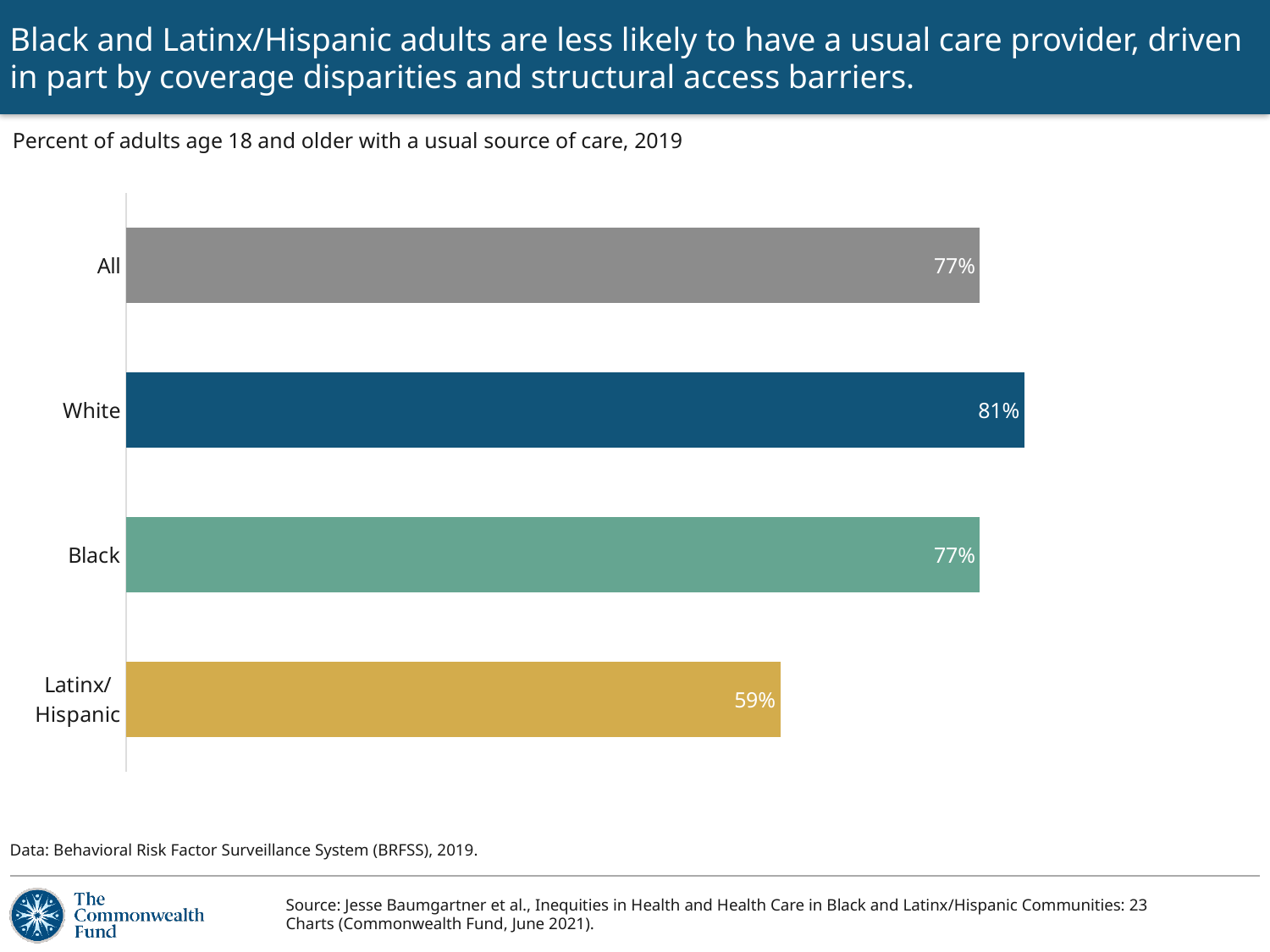
Which group has the lowest percent of adults with a usual source of care? Latinx/Hispanic What kind of chart is shown on the slide? Bar chart What is the value shown for Black adults? 77% What percent of White adults had a usual source of care in 2019? 81% What is the difference in percentage points between White and Black adults? 4 percentage points Which group has the highest percent of adults with a usual source of care? White How many groups are shown in the chart? 4 What is the difference in percentage points between White and Latinx/Hispanic adults? 22 percentage points What is the value shown for All adults? 77% What percent of Latinx/Hispanic adults had a usual source of care in 2019? 59% Which is larger, the value for Black adults or the value for Latinx/Hispanic adults? Black What is the title of the chart? Percent of adults age 18 and older with a usual source of care, 2019